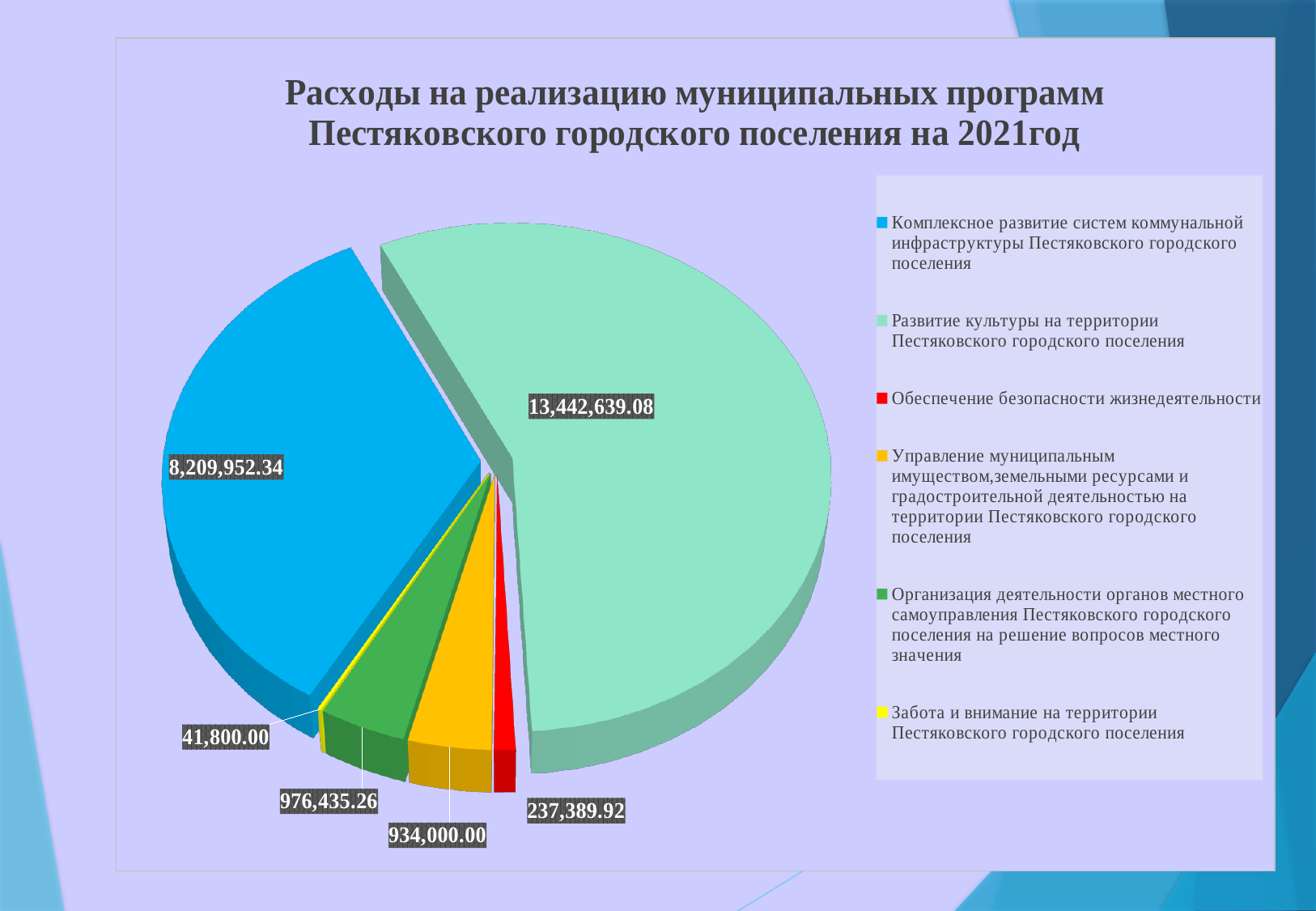
How many categories does the pie chart have? 6 Which category has the largest slice of the pie? Развитие культуры на территории Пестяковского городского поселения What is the value for "Забота и внимание на территории Пестяковского городского поселения"? 41,800.00 What is the difference between the value for "Развитие культуры" and the value for "Комплексное развитие систем коммунальной инфраструктуры"? 5,232,686.74 Which is larger: the value for "Организация деятельности органов местного самоуправления" or the value for "Управление муниципальным имуществом"? Организация деятельности органов местного самоуправления What is the value for "Развитие культуры на территории Пестяковского городского поселения"? 13,442,639.08 What is the value for "Обеспечение безопасности жизнедеятельности"? 237,389.92 What is the value for "Организация деятельности органов местного самоуправления Пестяковского городского поселения на решение вопросов местного значения"? 976,435.26 What kind of chart is shown on the slide? Pie chart What colour is the slice for "Обеспечение безопасности жизнедеятельности"? Red Which category has the smallest slice of the pie? Забота и внимание на территории Пестяковского городского поселения What is the value for "Комплексное развитие систем коммунальной инфраструктуры Пестяковского городского поселения"? 8,209,952.34